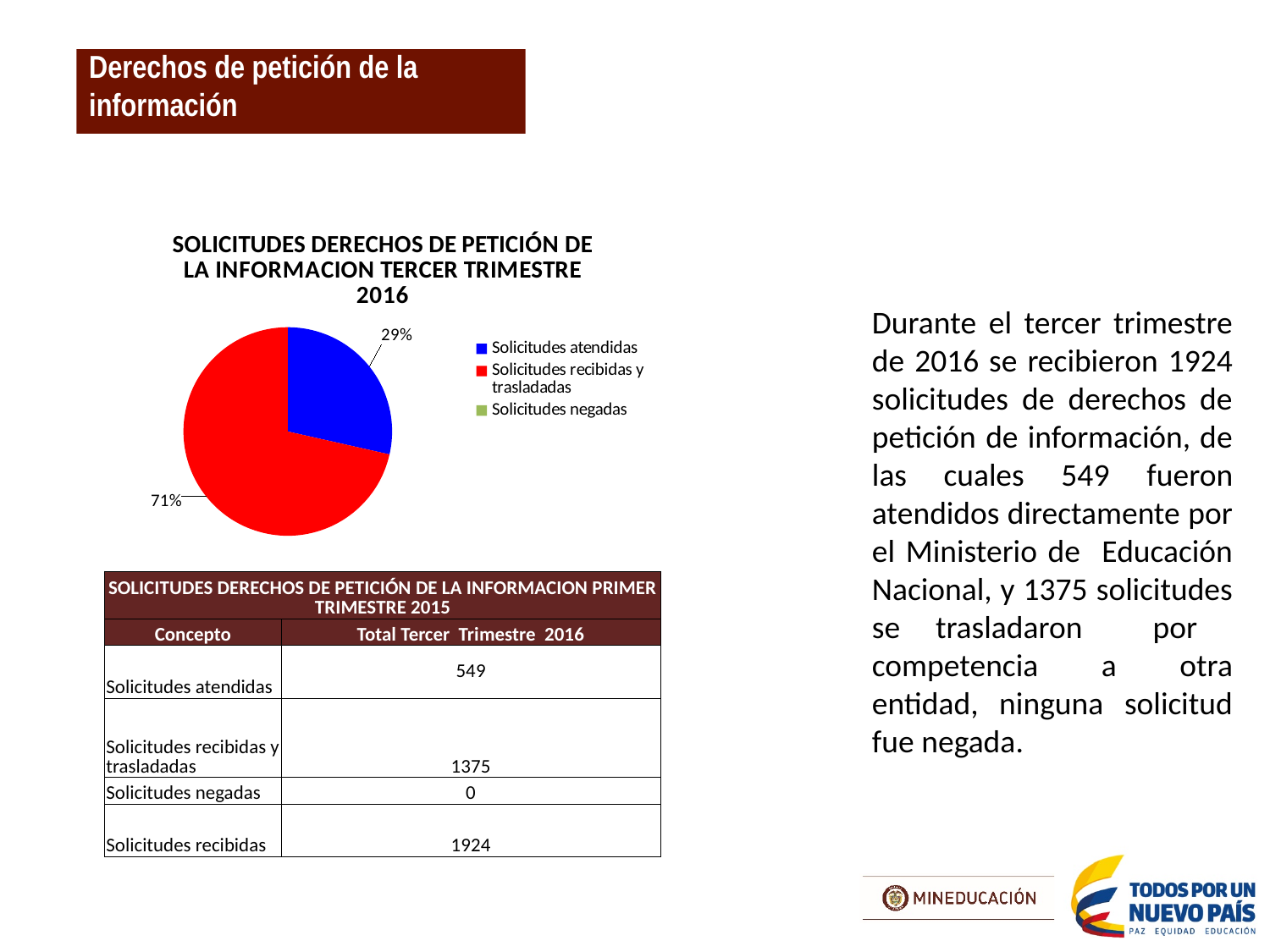
Which legend entry has no visible slice in the pie chart? Solicitudes negadas What kind of chart is shown on the slide? pie chart What is the title of the pie chart? SOLICITUDES DERECHOS DE PETICIÓN DE LA INFORMACION TERCER TRIMESTRE 2016 Which of the two labelled slices is smaller, "Solicitudes atendidas" or "Solicitudes recibidas y trasladadas"? Solicitudes atendidas By how many percentage points does the "Solicitudes recibidas y trasladadas" share exceed the "Solicitudes atendidas" share? 42 percentage points Is the share for "Solicitudes recibidas y trasladadas" greater or less than 50%? greater Is the share for "Solicitudes atendidas" greater or less than 50%? less What share of the pie does "Solicitudes recibidas y trasladadas" represent? 71% Which category has the largest slice of the pie? Solicitudes recibidas y trasladadas How many entries does the legend of the pie chart list? 3 What colour is the "Solicitudes atendidas" slice in the pie chart? blue What share of the pie does "Solicitudes atendidas" represent? 29%